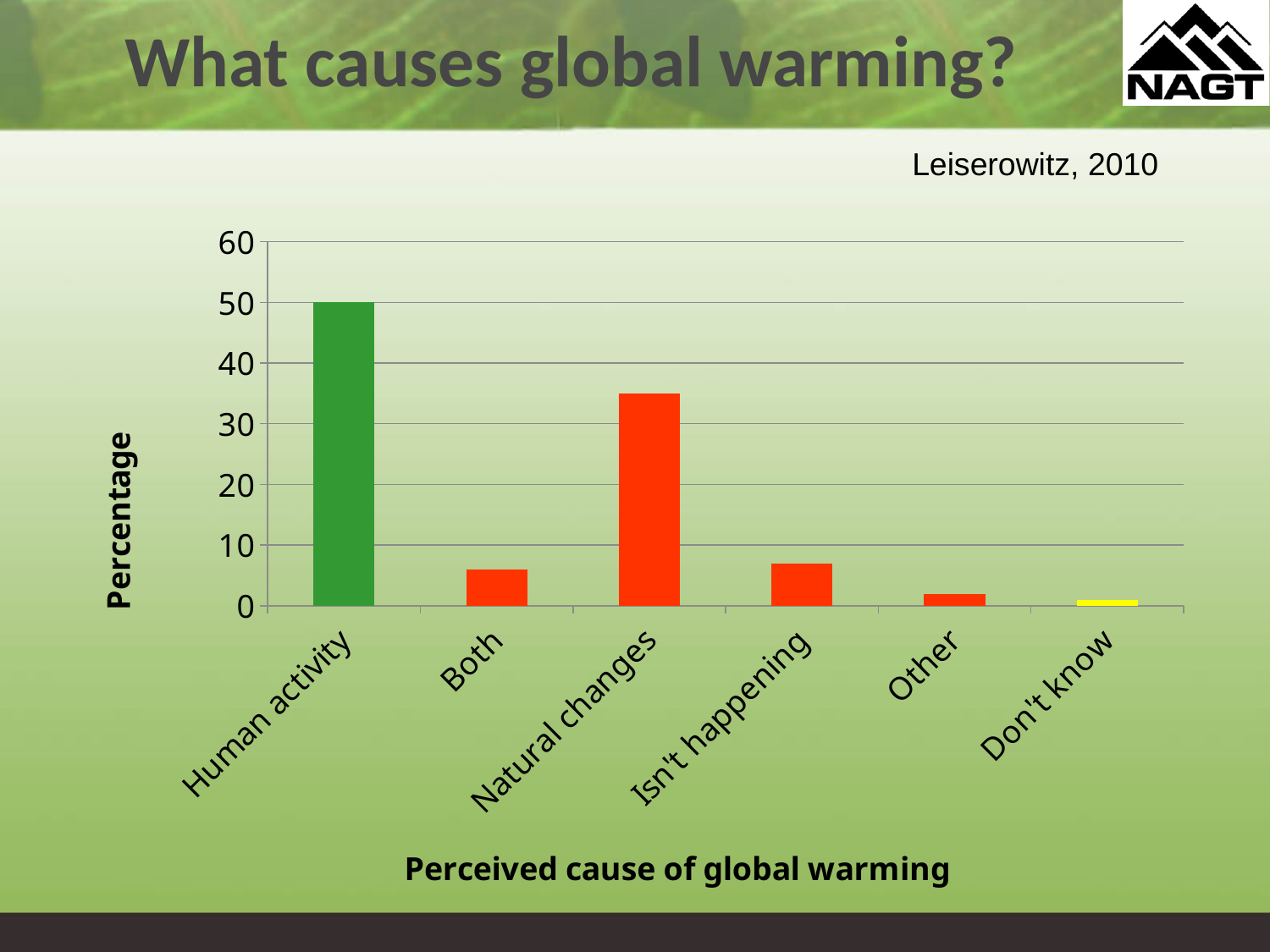
What kind of chart is shown on the slide? bar chart Which perceived cause has the highest percentage? Human activity How many perceived causes of global warming are shown on the x axis? 6 Is the value for Isn't happening greater or less than 10? less Is the value for Natural changes greater or less than 40? less What is the title of the x axis? Perceived cause of global warming Which perceived cause has the lowest percentage? Don't know Is the value for Both greater or less than 10? less What is the percentage for Human activity? 50 Which has a higher percentage, Natural changes or Both? Natural changes Which has a higher percentage, Isn't happening or Other? Isn't happening